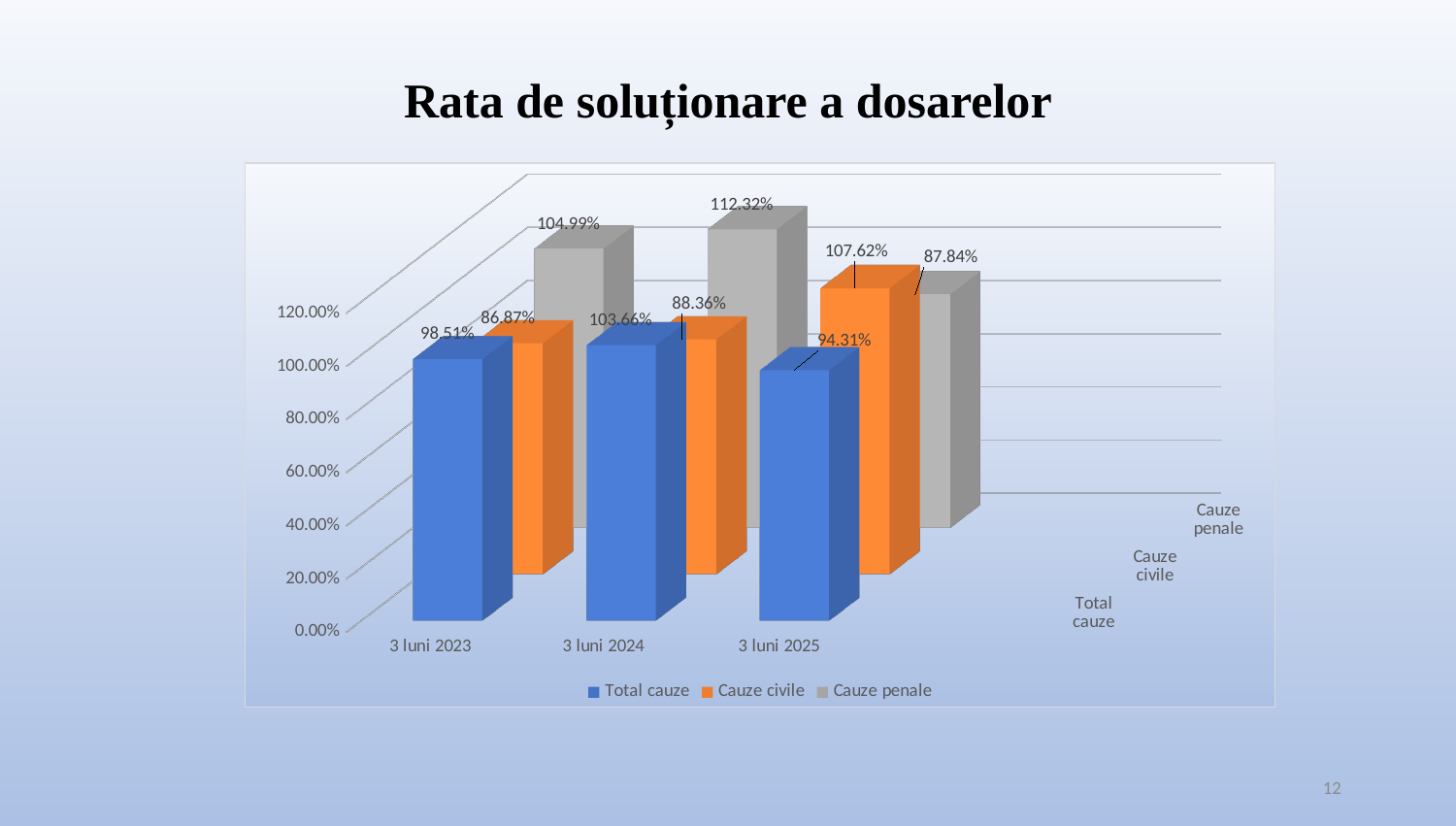
Which is larger in 3 luni 2024: Total cauze or Cauze civile? Total cauze Which period has the lowest value for Total cauze? 3 luni 2025 What is the value for Cauze penale in 3 luni 2024? 112.32% What kind of chart is shown on the slide? Bar chart What is the difference between Cauze penale and Cauze civile in 3 luni 2023? 18.12% How many periods are shown on the x axis? 3 What is the value for Cauze penale in 3 luni 2025? 87.84% What is the value for Total cauze in 3 luni 2023? 98.51% What is the value for Cauze civile in 3 luni 2025? 107.62% What is the title of the chart? Rata de soluționare a dosarelor How many series does the legend list? 3 Which period has the highest value for Cauze penale? 3 luni 2024